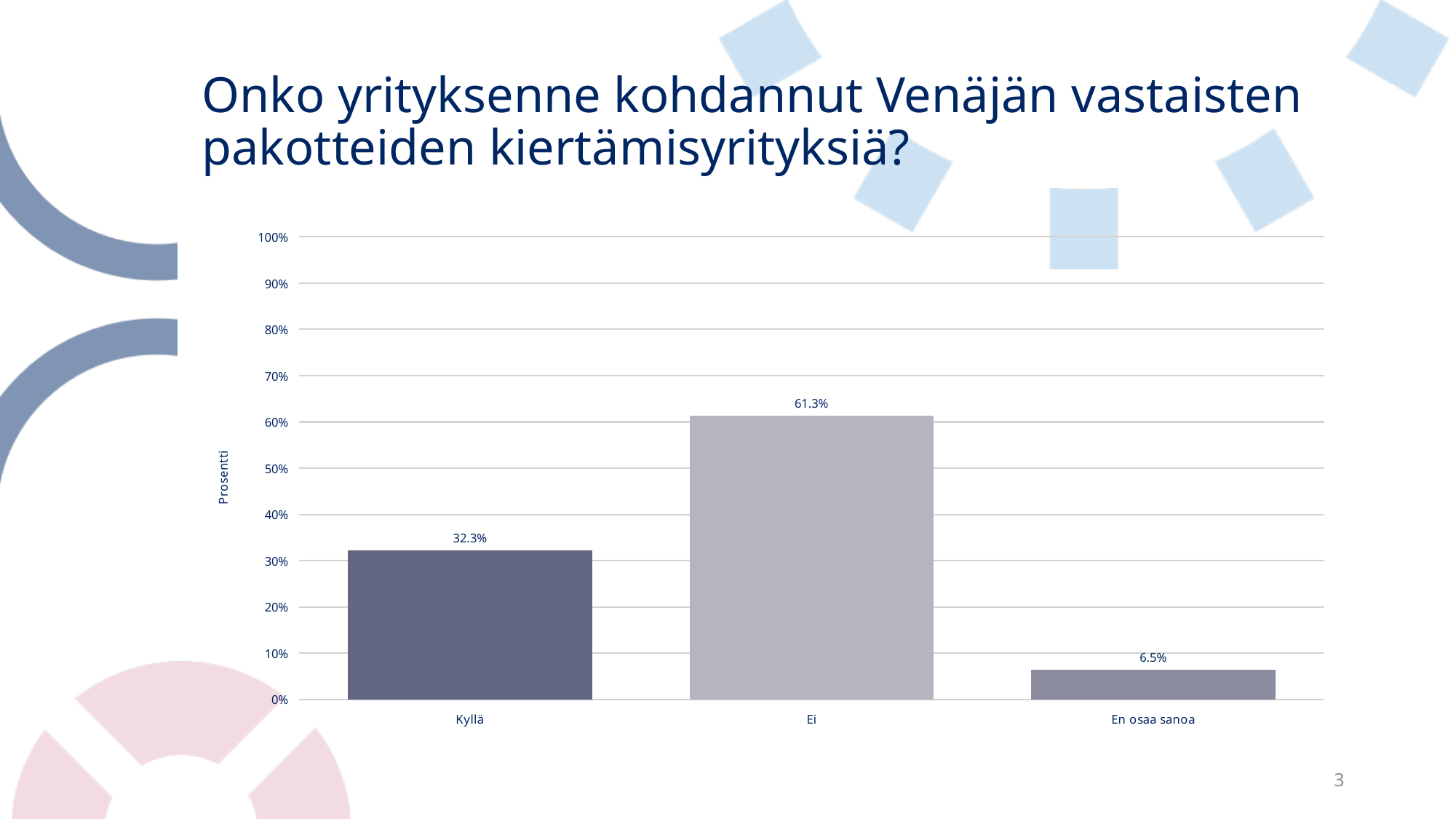
What is the difference between the values for Ei and Kyllä? 29.0 percentage points How many categories are shown on the x axis? 3 What is the title of the chart? Onko yrityksenne kohdannut Venäjän vastaisten pakotteiden kiertämisyrityksiä? What is the value for Ei? 61.3% What kind of chart is shown on the slide? bar chart What is the value for Kyllä? 32.3% Is the value for Ei greater or less than 50%? greater What is the value for En osaa sanoa? 6.5% What is the label of the vertical axis? Prosentti Which is larger, the value for Kyllä or the value for En osaa sanoa? Kyllä Which category has the highest value? Ei Which category has the lowest value? En osaa sanoa